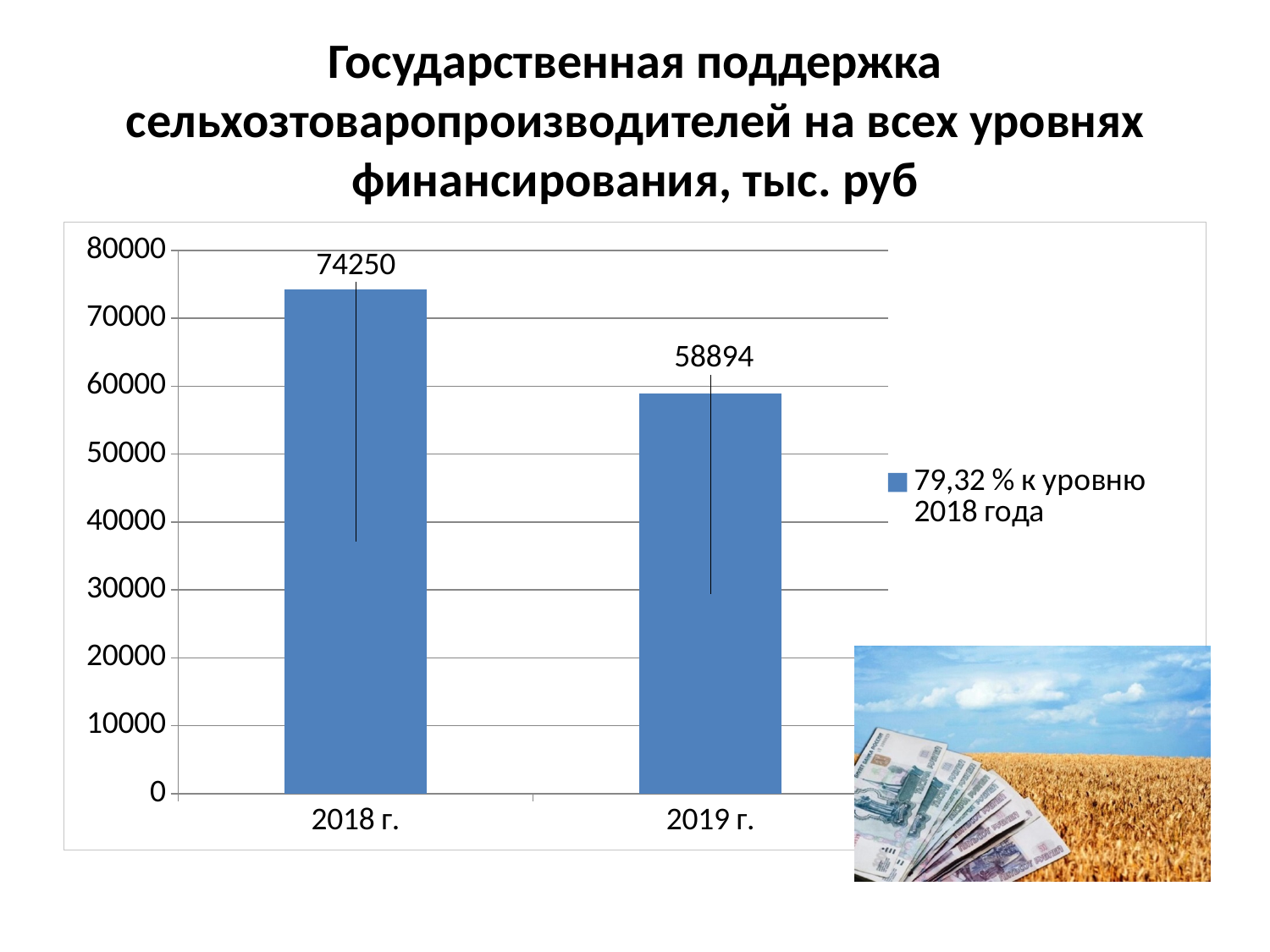
What kind of chart is shown? bar chart What is the difference between the values for 2018 г. and 2019 г.? 15356 What is the value for 2019 г.? 58894 Is the value for 2018 г. greater or less than 70000? greater What is the value for 2018 г.? 74250 Which year has the lower value? 2019 г. How many categories are shown on the x axis? 2 What is the legend entry of the chart? 79,32 % к уровню 2018 года How many series does the legend list? 1 Which year has the higher value? 2018 г. Is the value for 2019 г. greater or less than 60000? less Is the value for 2018 г. larger or smaller than the value for 2019 г.? larger